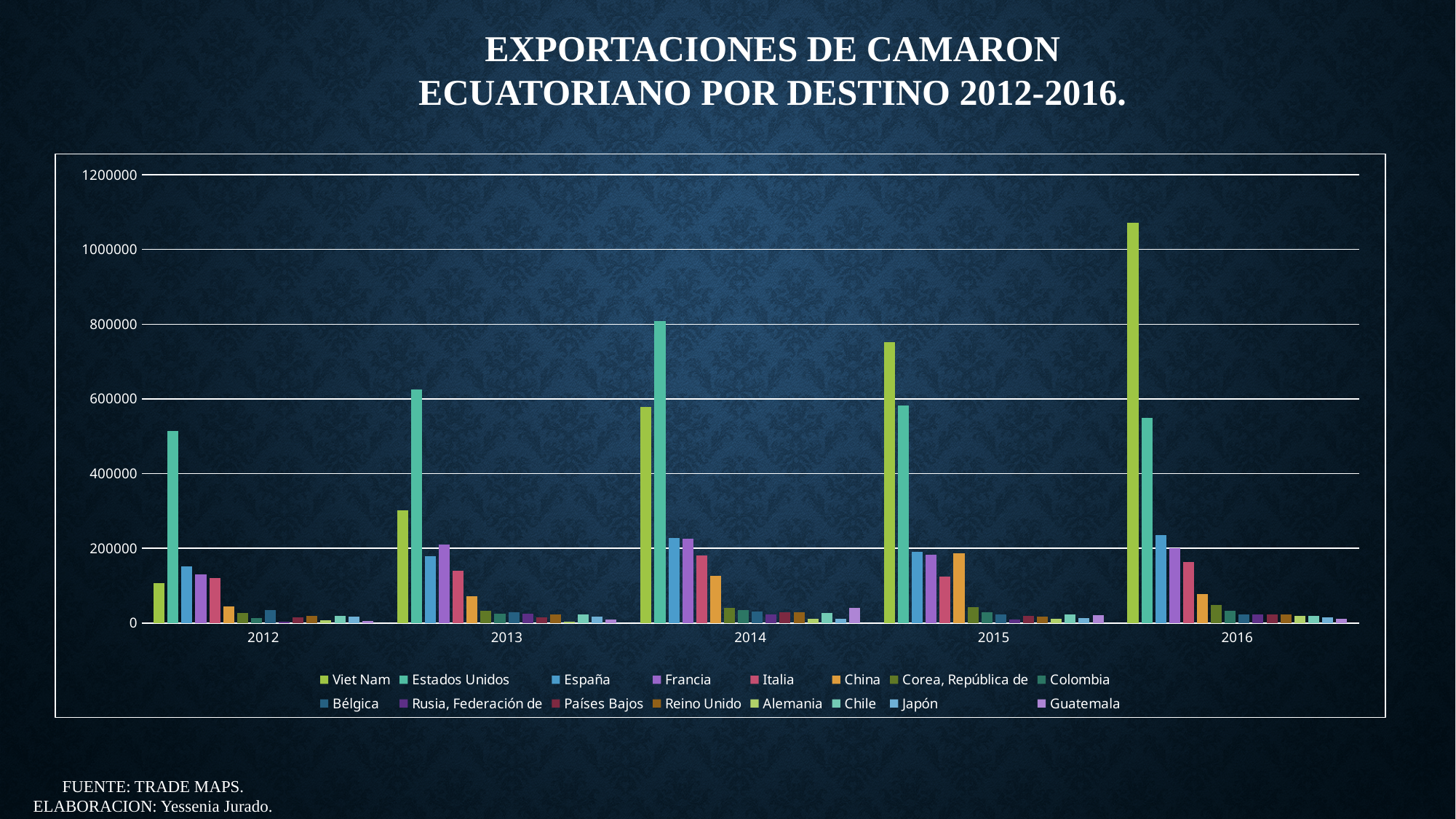
Is the value for Estados Unidos in 2014 greater or less than 600000? greater How many years are shown on the x axis? 5 How many series does the legend list? 16 In which year is the Estados Unidos bar highest? 2014 Do the values for Viet Nam rise or fall from 2012 to 2016? rise Which destination has the tallest bar in 2016? Viet Nam Is the value for Viet Nam in 2016 greater or less than 1000000? greater Is the value for Viet Nam in 2012 greater or less than 200000? less What kind of chart is shown on the slide? bar chart In which year is the Viet Nam bar highest? 2016 In 2014, which is larger: the value for Viet Nam or the value for Estados Unidos? Estados Unidos